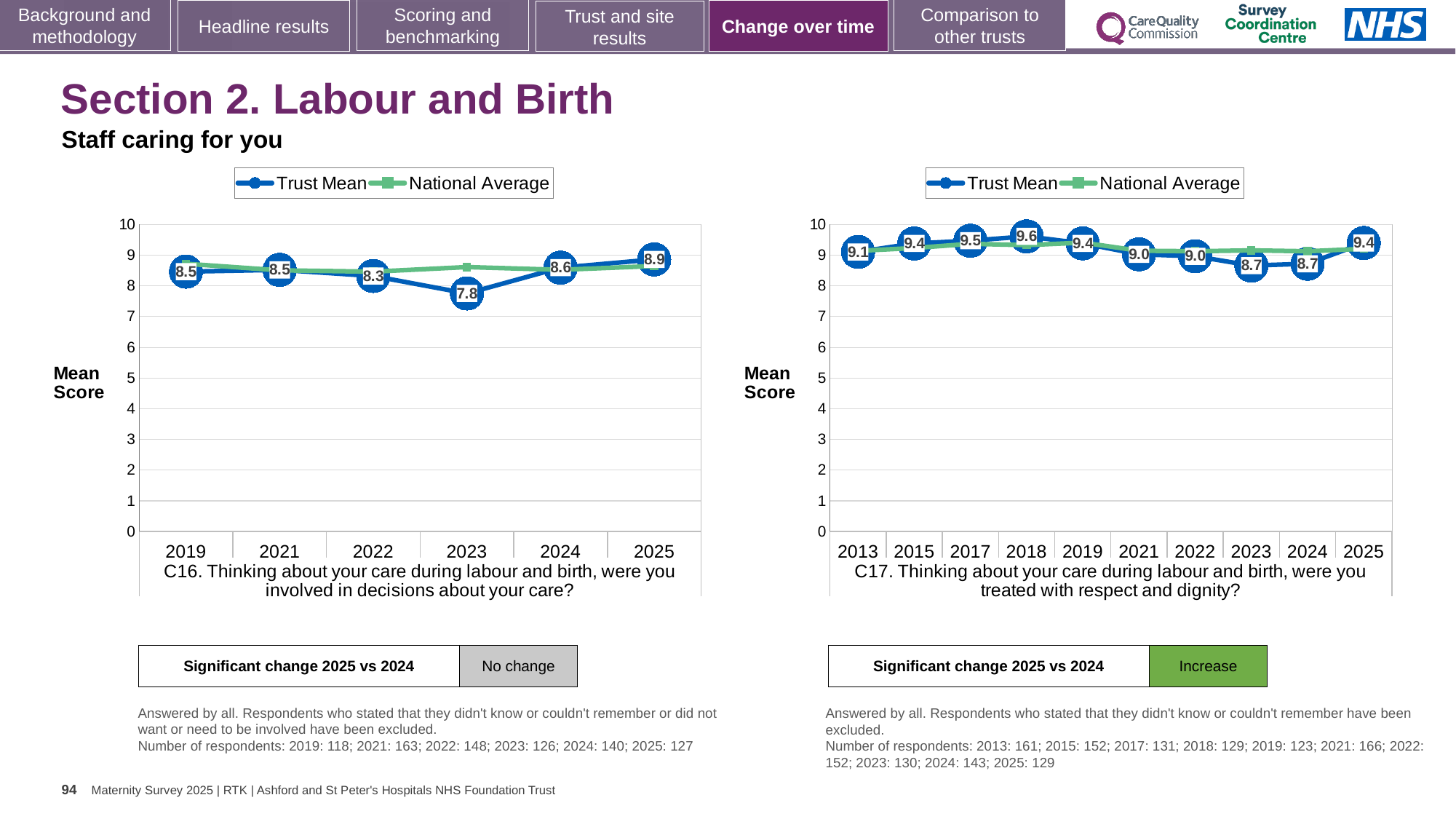
In the C16 chart (left), what is the difference between the Trust Mean scores for 2025 and 2023? 1.1 In the C17 chart (right), which year has the highest Trust Mean score? 2018 In the C16 chart (left), which year has the lowest Trust Mean score? 2023 What type of chart is the C17 chart (right)? Line chart In the C17 chart (right), how many series does the legend list? 2 In the C16 chart (left), what is the Trust Mean score for 2025? 8.9 In the C16 chart (left), is the National Average value for 2023 greater or less than 8? greater What does the 'Significant change 2025 vs 2024' box below the C17 chart (right) say? Increase In the C17 chart (right), what is the Trust Mean score for 2018? 9.6 In the C17 chart (right), is the Trust Mean score for 2013 larger or smaller than the score for 2025? smaller In the C16 chart (left), what is the Trust Mean score for 2023? 7.8 In the C16 chart (left), how many years are plotted on the x axis? 6